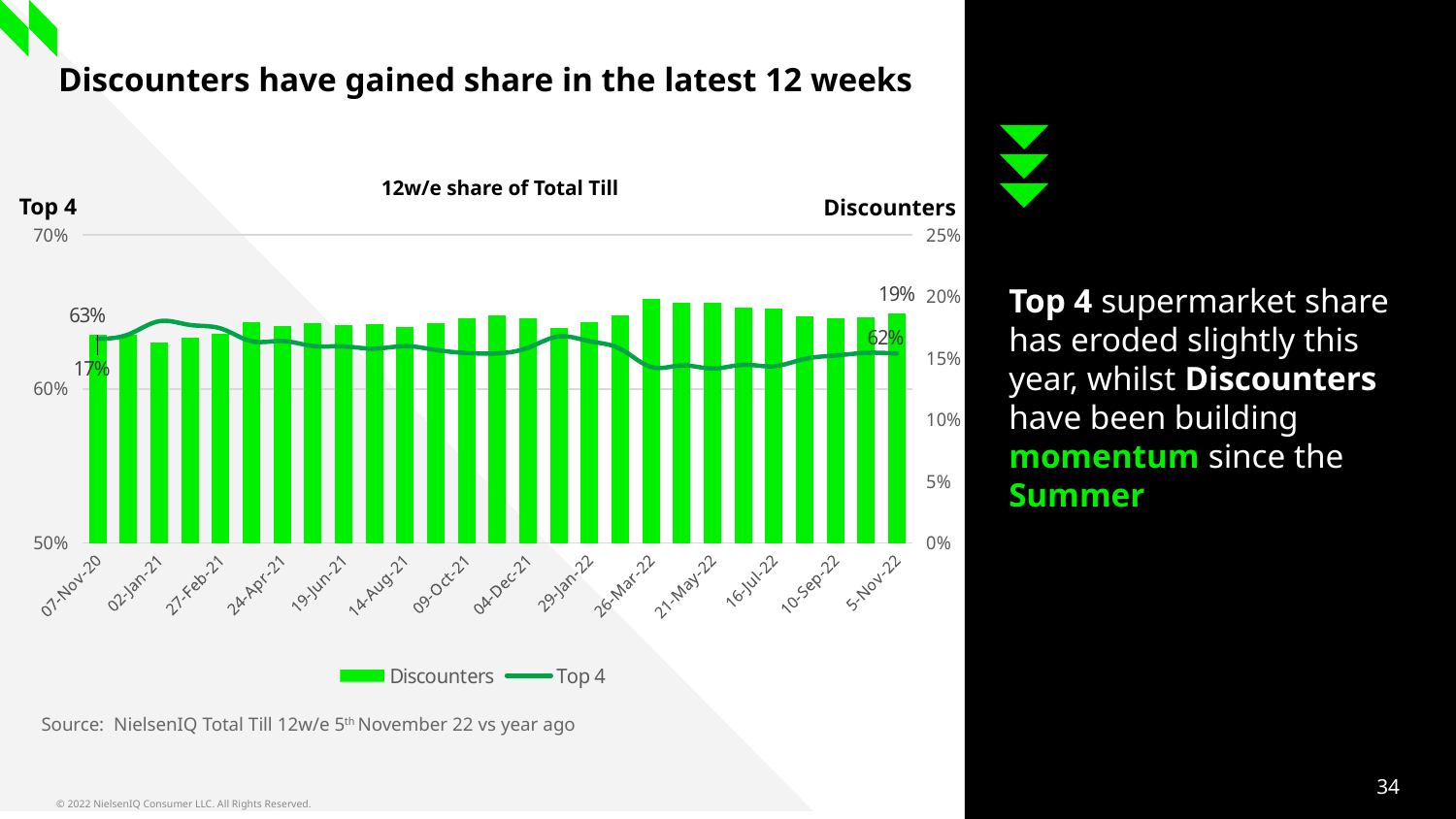
What is the Top 4 share at 07-Nov-20? 63% What is the Top 4 share at 5-Nov-22? 62% By how many percentage points did the Discounters share change between 07-Nov-20 and 5-Nov-22? 2 percentage points Which series is plotted as bars rather than a line? Discounters What is the title of the chart? 12w/e share of Total Till How many series does the chart legend list? 2 Is the Discounters share larger at 07-Nov-20 or at 5-Nov-22? 5-Nov-22 By how many percentage points did the Top 4 share change between 07-Nov-20 and 5-Nov-22? 1 percentage point Is the Discounters share at 26-Mar-22 greater or less than 15%? greater Does the Top 4 line rise or fall from 07-Nov-20 to 5-Nov-22? Fall What is the Discounters share at 07-Nov-20? 17% What is the Discounters share at 5-Nov-22? 19%